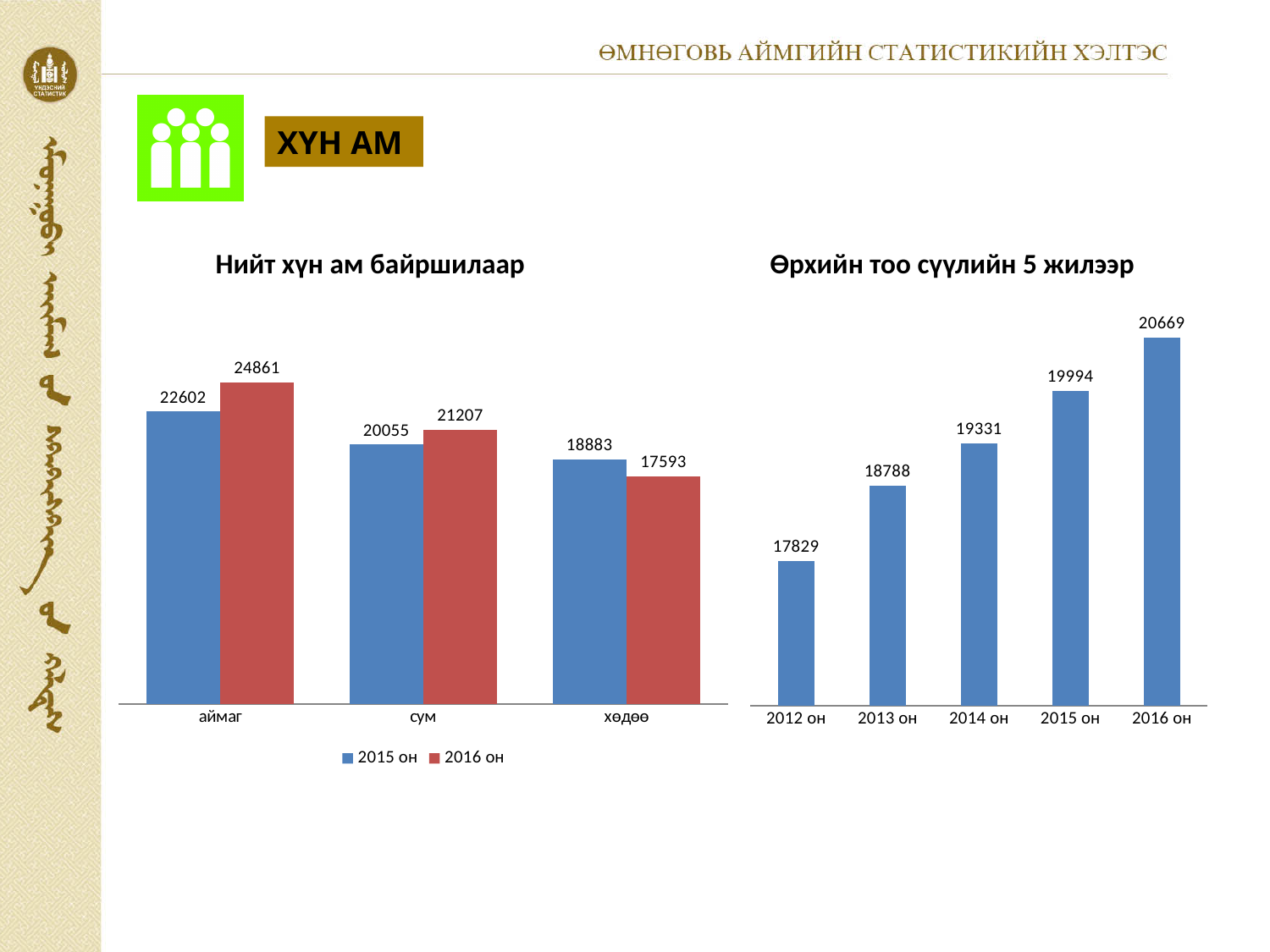
In the chart titled "Өрхийн тоо сүүлийн 5 жилээр", which year has the lowest value? 2012 он In the chart titled "Өрхийн тоо сүүлийн 5 жилээр", do the values rise or fall from 2012 он to 2016 он? rise In the chart titled "Нийт хүн ам байршилаар", which category has the highest 2016 он value? аймаг In the chart titled "Өрхийн тоо сүүлийн 5 жилээр", what is the value for 2014 он? 19331 In the chart titled "Нийт хүн ам байршилаар", what is the difference between the 2016 он and 2015 он values for сум? 1152 In the chart titled "Нийт хүн ам байршилаар", how many series does the legend list? 2 In the chart titled "Нийт хүн ам байршилаар", which is larger for хөдөө: the 2015 он value or the 2016 он value? 2015 он In the chart titled "Нийт хүн ам байршилаар", how many categories are shown on the x axis? 3 In the chart titled "Нийт хүн ам байршилаар", what is the value for хөдөө in the 2015 он series? 18883 In the chart titled "Өрхийн тоо сүүлийн 5 жилээр", what is the difference between the 2016 он and 2012 он values? 2840 In the chart titled "Нийт хүн ам байршилаар", what is the value for аймаг in the 2016 он series? 24861 What kind of chart is the chart titled "Өрхийн тоо сүүлийн 5 жилээр"? bar chart